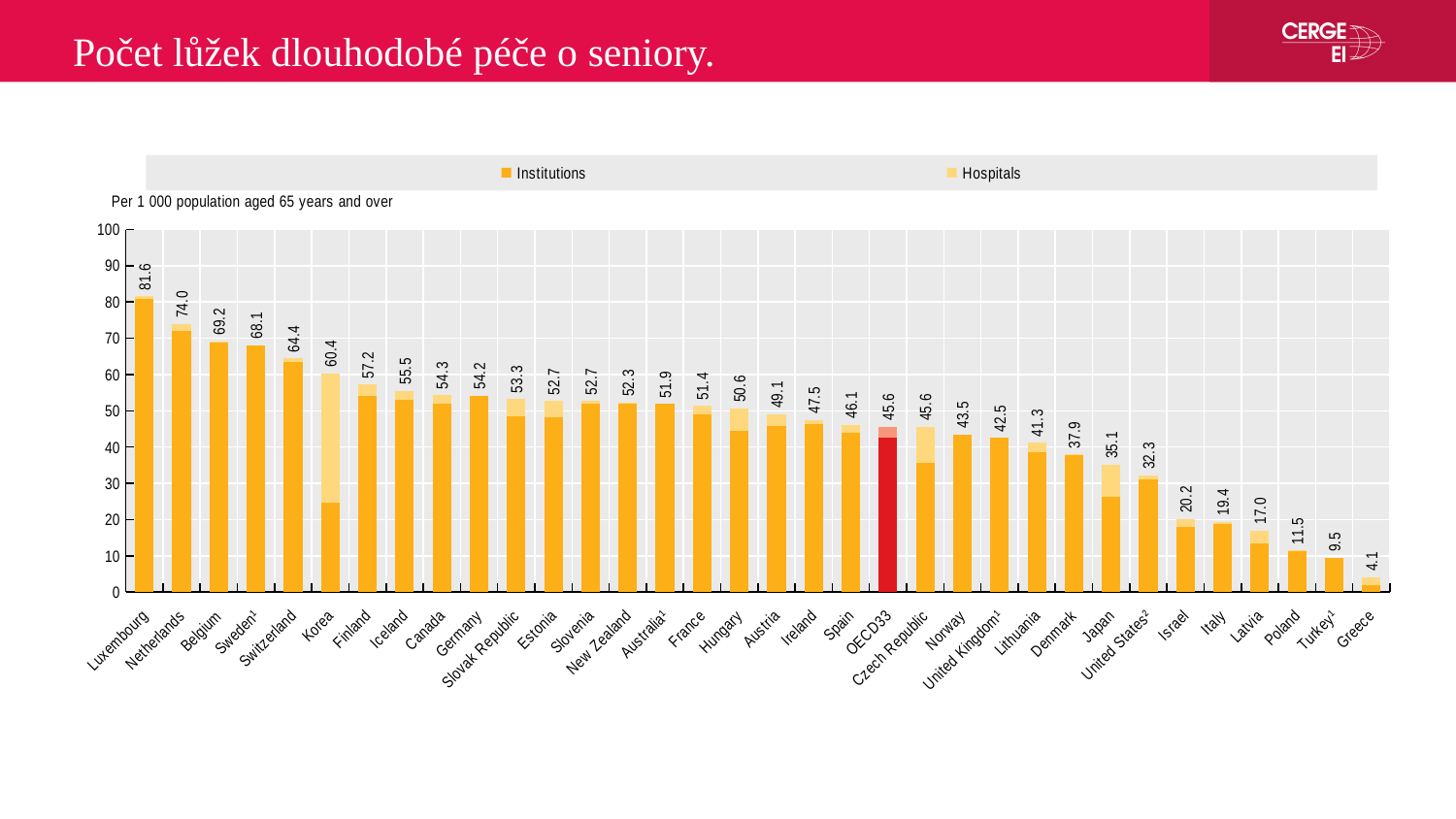
Which country has the lowest value on the chart? Greece Which country has the highest number of long-term care beds per 1 000 population aged 65 and over? Luxembourg Which has a higher total value, Norway or Denmark? Norway Is the Institutions portion of Korea's bar greater or less than 30? less What is the total value shown for the Czech Republic? 45.6 What kind of chart is shown on the slide? Stacked bar chart How many series does the legend list? 2 What is the difference between the values for Netherlands and Belgium? 4.8 What is the total value shown for Japan? 35.1 Do the total values rise or fall moving from left to right along the x axis? Fall How many categories (bars) are shown on the x axis? 34 What is the total value shown for Luxembourg? 81.6